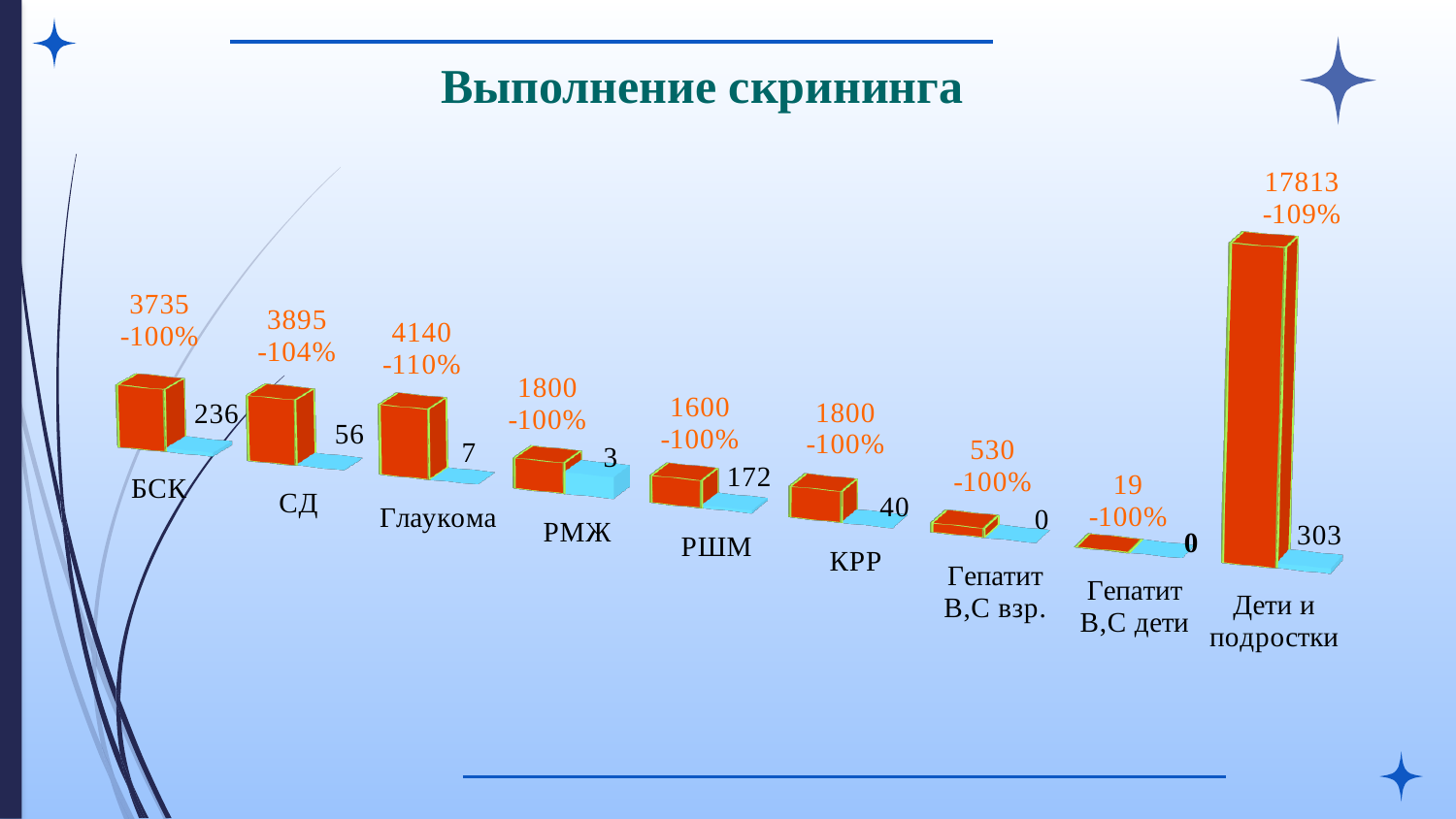
Which category has the highest orange bar? Дети и подростки What is the value of the blue bar for БСК? 236 What is the title of the chart? Выполнение скрининга What is the difference between the orange bar values for Глаукома and БСК? 405 Which category has the lowest orange bar value? Гепатит В,С дети What is the value of the blue bar for Дети и подростки? 303 What is the value of the orange bar for Гепатит В,С взр.? 530 Which has a larger blue bar value, РШМ or КРР? РШМ How many categories are shown on the x axis of the chart? 9 What percentage is shown next to the orange bar for СД? -104% What is the value of the orange bar for Глаукома? 4140 What type of chart is shown on the slide? bar chart